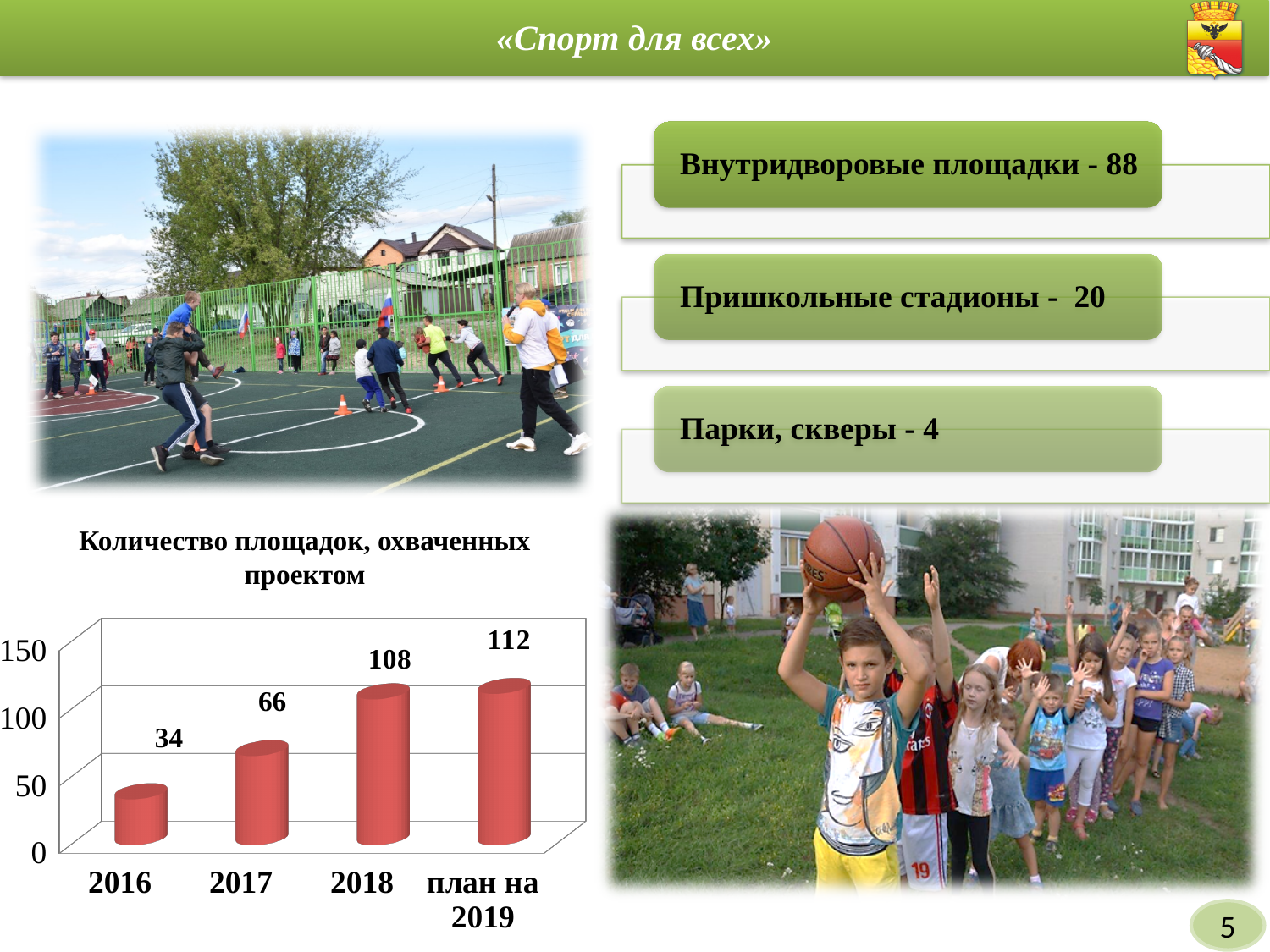
What is the value for 2016 in the chart 'Количество площадок, охваченных проектом'? 34 What is the value for 'план на 2019' in the chart? 112 What is the title of the chart on the slide? Количество площадок, охваченных проектом How many categories are shown on the x axis of the chart? 4 What is the value for 2017 in the chart? 66 Which category has the highest value in the chart? план на 2019 What is the difference between the values for 2018 and 2017? 42 What kind of chart is shown on the slide? bar chart Do the values rise or fall from 2016 to 'план на 2019'? rise Which is larger, the value for 2017 or the value for 2018? 2018 Which category has the lowest value in the chart? 2016 What is the value for 2018 in the chart? 108